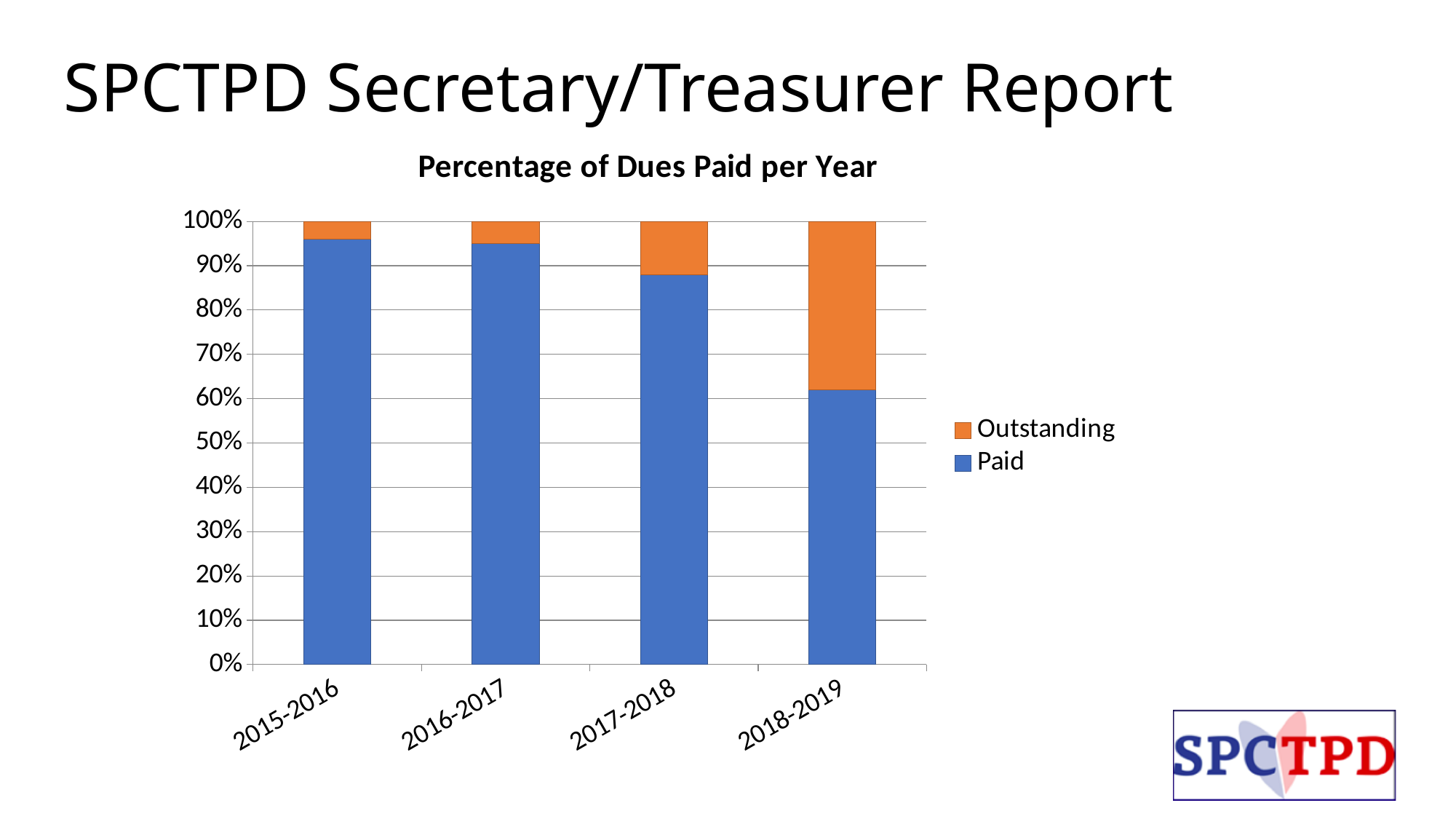
Is the Paid value for 2015-2016 greater or less than 90%? greater Does the Paid percentage rise or fall from 2015-2016 to 2018-2019? Fall Is the Paid value for 2017-2018 greater or less than 80%? greater What kind of chart is shown on the slide? Stacked bar chart Which year has the lowest Paid percentage? 2018-2019 What is the total of the stacked bar for 2018-2019? 100% How many series does the chart legend list? 2 What is the title of the chart? Percentage of Dues Paid per Year How many years (categories) are shown on the x axis of the chart? 4 Which year has a larger Paid percentage, 2017-2018 or 2018-2019? 2017-2018 Is the Paid value for 2018-2019 greater or less than 70%? less Which year has the largest Outstanding share? 2018-2019